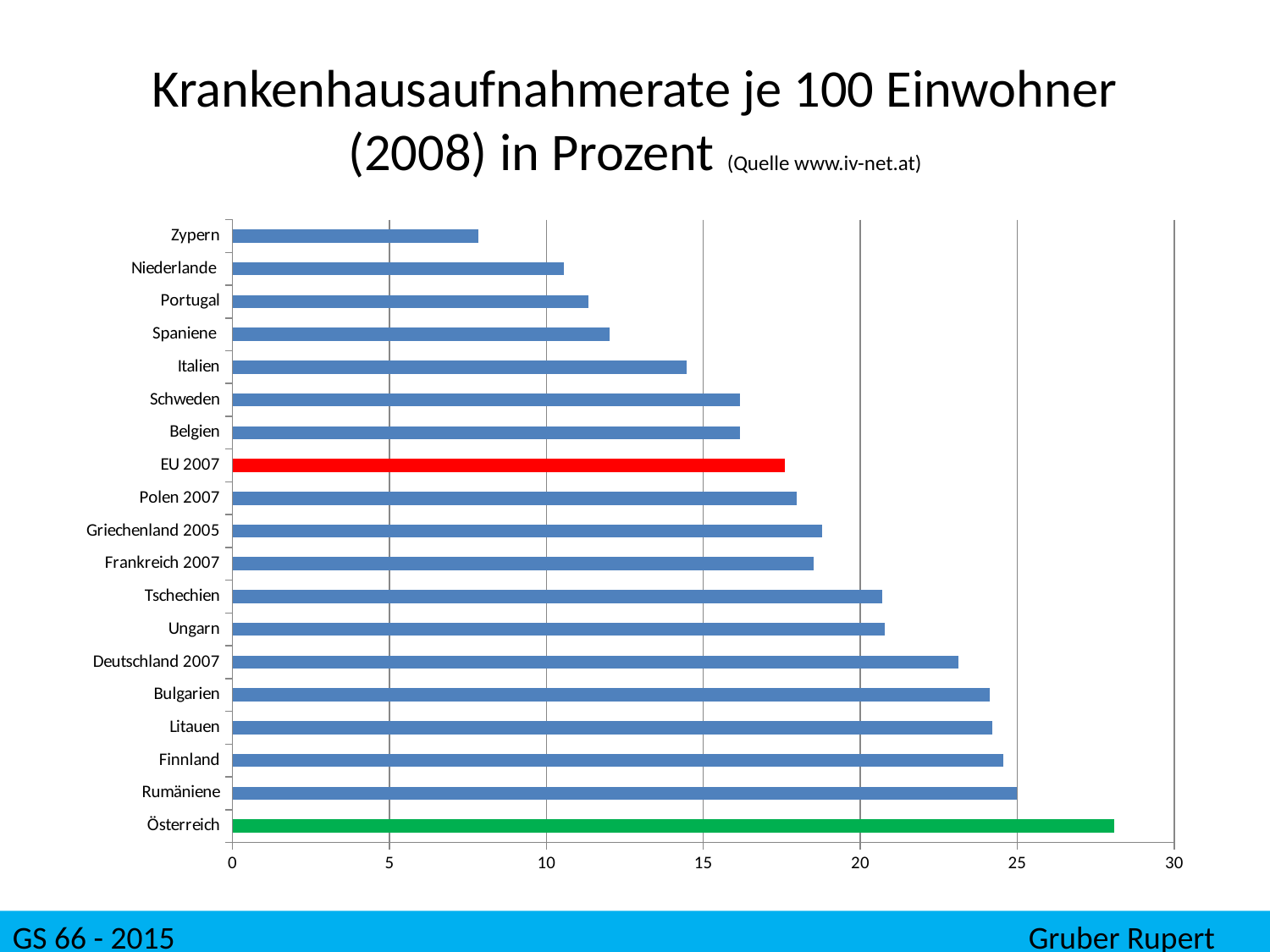
Is the value for Österreich greater or less than 25? greater What kind of chart is shown on the slide? bar chart Is the value for Zypern greater or less than 10? less Which has the larger value, Deutschland 2007 or Italien? Deutschland 2007 Which country has the highest hospital admission rate in the chart? Österreich Is the value for Italien greater or less than 15? less Which has the larger value, Polen 2007 or Belgien? Polen 2007 What colour is the bar for EU 2007? red Which country has the lowest hospital admission rate in the chart? Zypern How many categories are plotted in the chart? 19